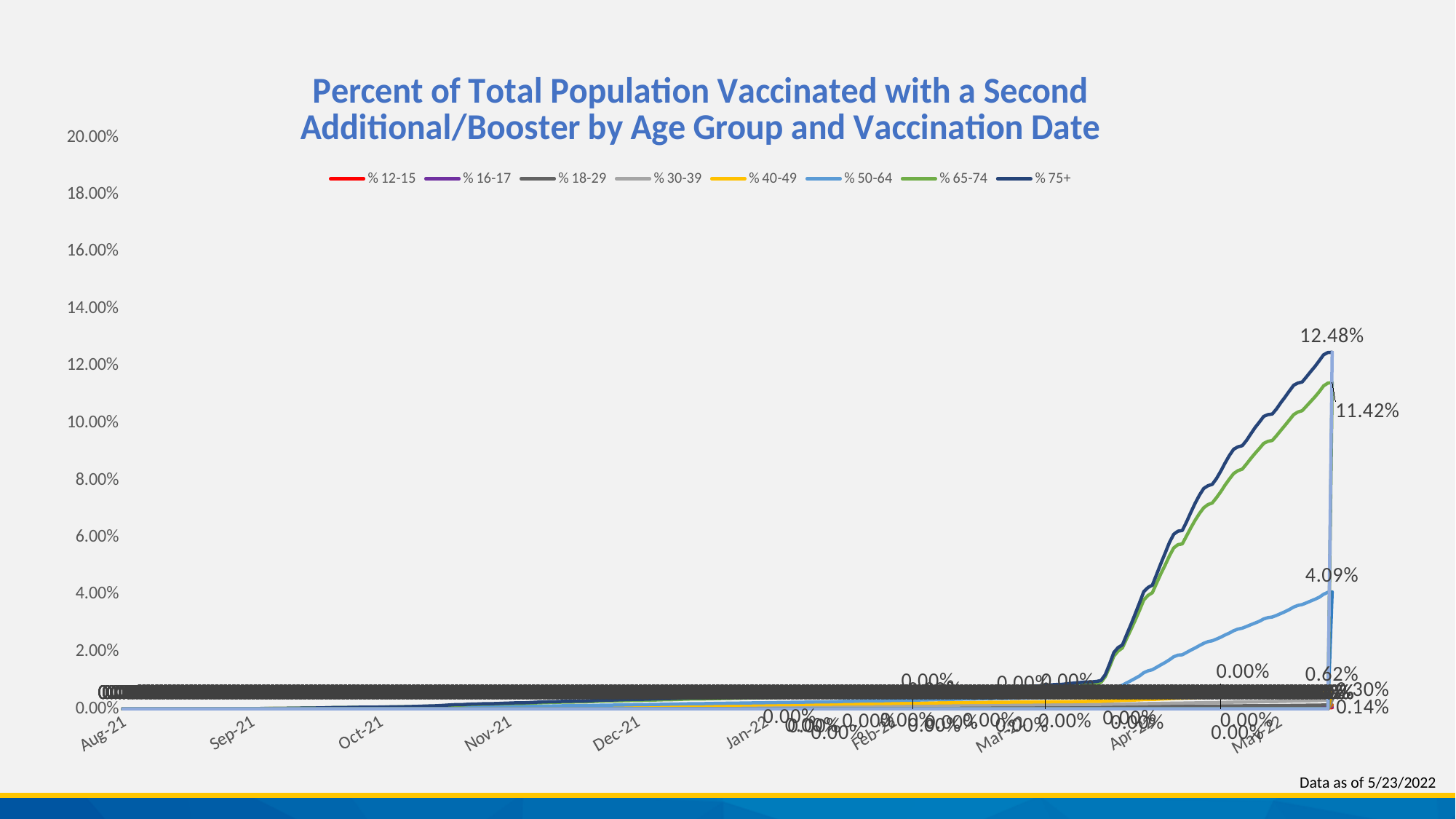
What is the peak value labelled for the % 75+ series? 12.48% Which series reaches a higher peak, % 65-74 or % 50-64? % 65-74 What is the difference between the peak values of the % 75+ and % 50-64 series? 8.39% What kind of chart is shown on the slide? line chart Which age group series reaches the highest value on the chart? % 75+ What is the peak value labelled for the % 65-74 series? 11.42% What is the difference between the peak values of the % 75+ and % 65-74 series? 1.06% Is the peak value of the % 50-64 series greater or less than 6.00%? less Does the % 75+ line rise or fall between Apr-22 and May-22? rise What is the title of the chart? Percent of Total Population Vaccinated with a Second Additional/Booster by Age Group and Vaccination Date What is the peak value labelled for the % 50-64 series? 4.09% How many series does the legend list? 8